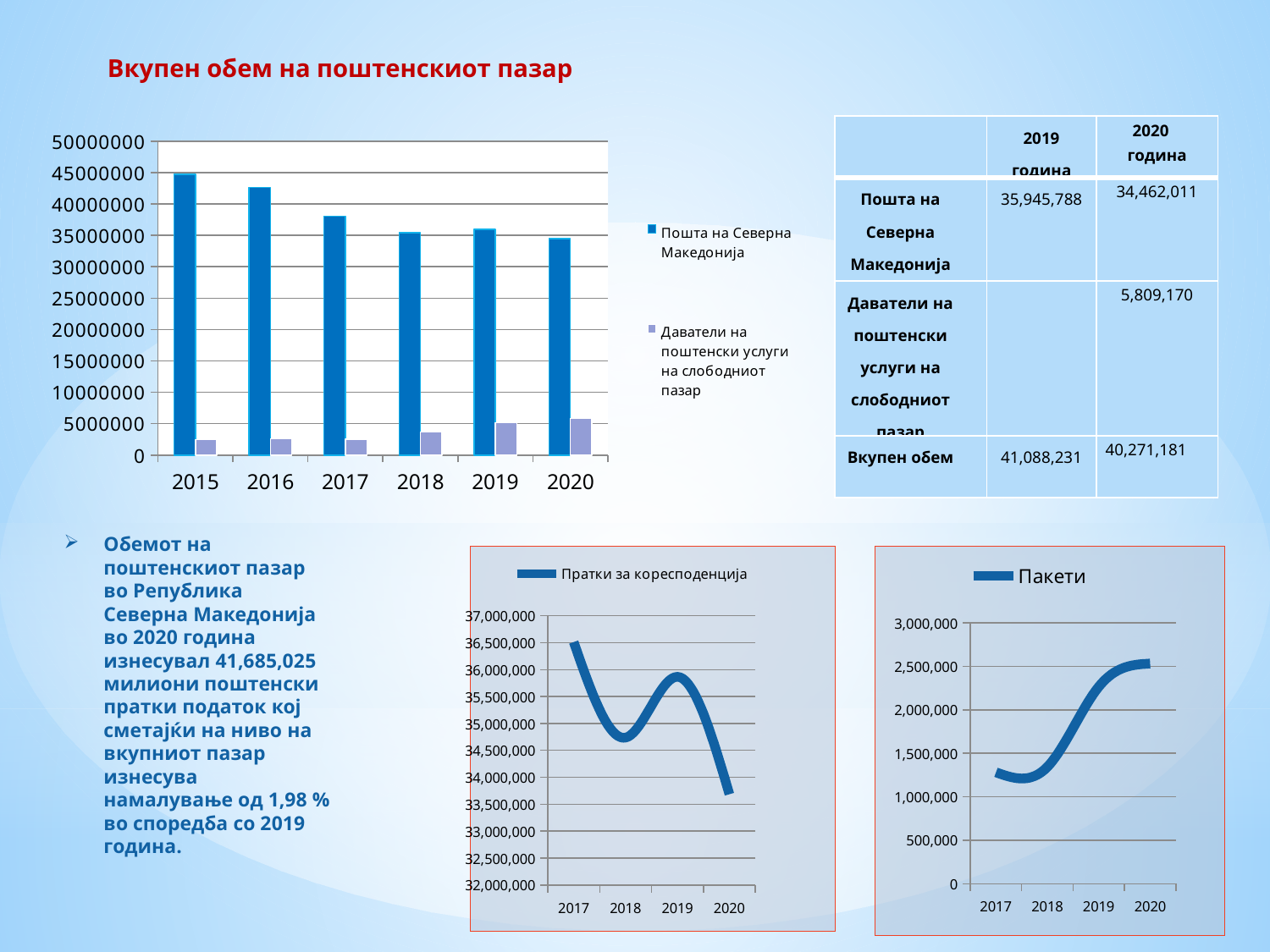
In the top-left bar chart, which year has the highest value for Даватели на поштенски услуги на слободниот пазар? 2020 In the chart titled Пакети, do the values rise or fall from 2017 to 2020? rise In the chart titled Пакети, is the value for 2020 greater or less than 2,000,000? greater In the top-left bar chart, do the values for Пошта на Северна Македонија generally rise or fall from 2015 to 2020? fall In the top-left bar chart, how many years are shown on the x axis? 6 In the top-left bar chart, is the value for Пошта на Северна Македонија in 2015 greater or less than 40000000? greater In the top-left bar chart, is the value for Даватели на поштенски услуги на слободниот пазар in 2020 greater or less than 5000000? greater What kind of chart is the chart titled Пратки за коресподенција? line chart In the top-left bar chart, which year has the highest value for Пошта на Северна Македонија? 2015 In the top-left bar chart, how many series does the legend list? 2 In the chart titled Пратки за коресподенција, which year has the highest value? 2017